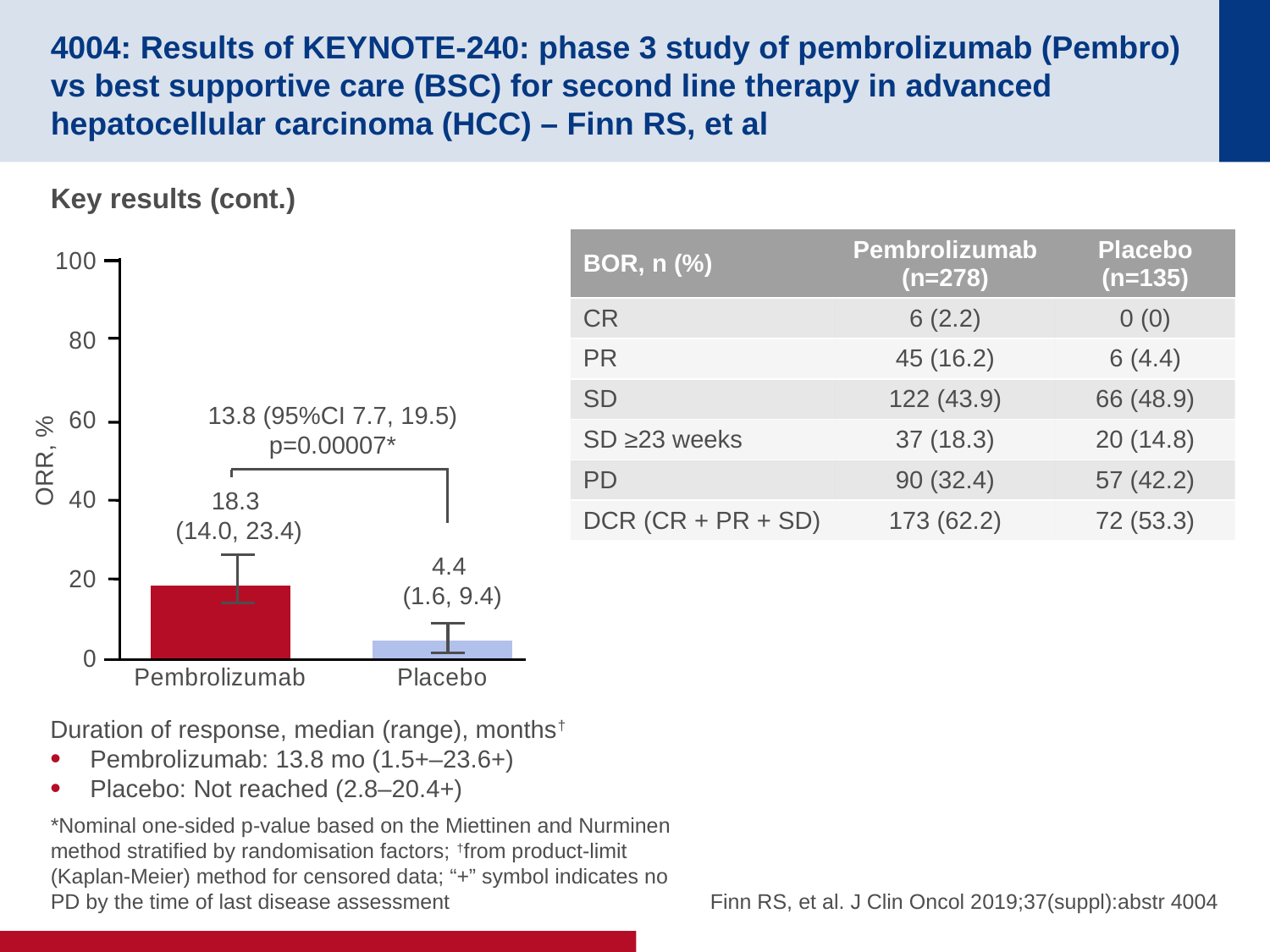
Is the ORR for Placebo greater or less than 20? less Which treatment arm has the higher ORR in the bar chart? Pembrolizumab What is the y-axis label of the bar chart? ORR, % How many treatment arms are shown in the bar chart? 2 What p-value is shown above the bars in the chart? p=0.00007* What is the ORR value for Placebo in the bar chart? 4.4 What type of chart is used to show ORR? Bar chart Which treatment arm has the lower ORR in the bar chart? Placebo What is the 95% CI shown for the Pembrolizumab ORR bar? (14.0, 23.4) What is the ORR value for Pembrolizumab in the bar chart? 18.3 Is the ORR for Pembrolizumab greater or less than 20? less